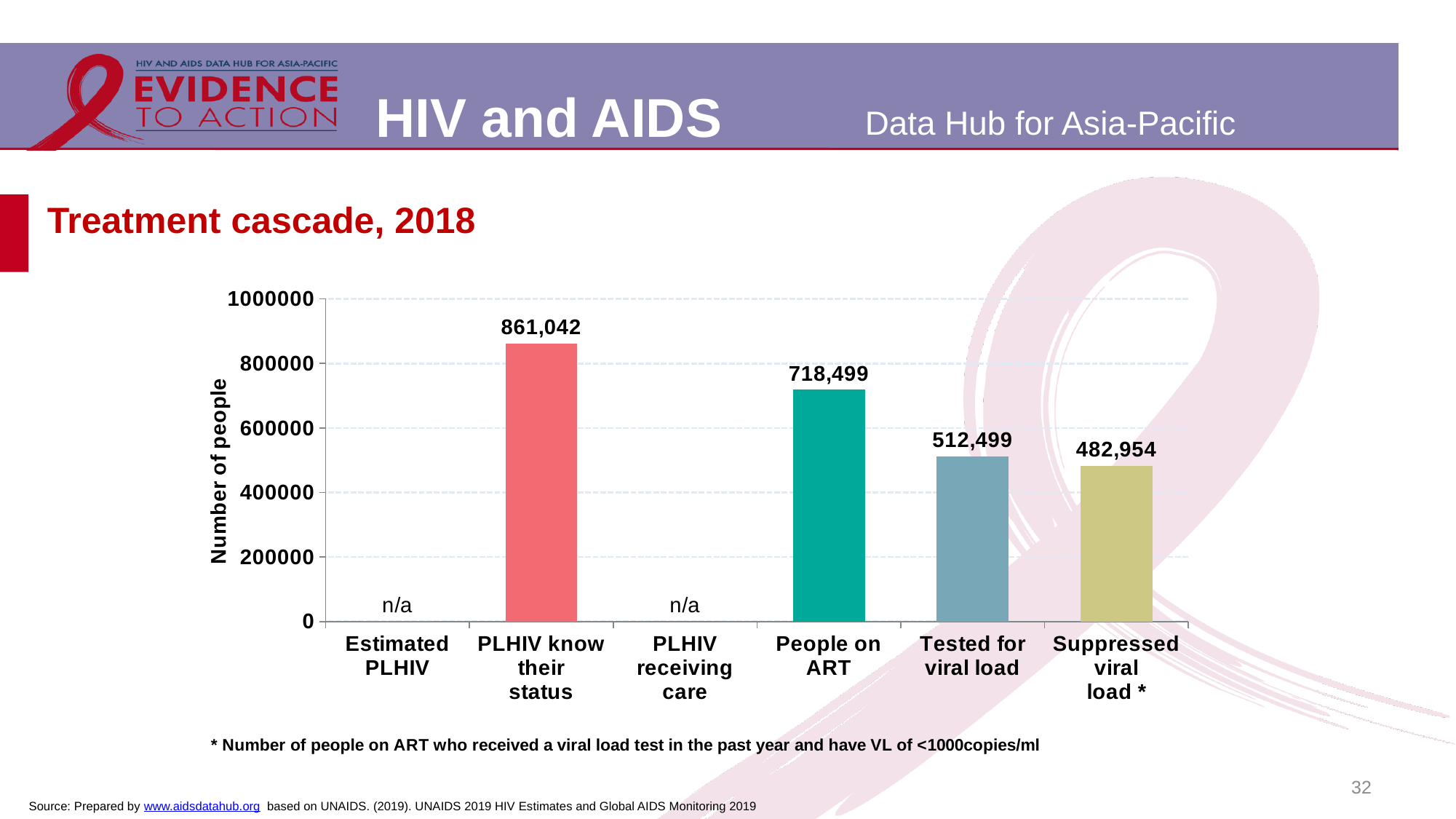
What is the value for PLHIV know their status? 861,042 What is the difference between Tested for viral load and Suppressed viral load? 29,545 Which category has the highest value? PLHIV know their status What is the value for People on ART? 718,499 Which category with a plotted bar has the lowest value? Suppressed viral load What kind of chart is this? bar chart What is the value for Suppressed viral load? 482,954 How many categories are shown on the x axis? 6 What label is shown for Estimated PLHIV and PLHIV receiving care? n/a What is the difference between PLHIV know their status and People on ART? 142,543 Which is larger, People on ART or Tested for viral load? People on ART What is the value for Tested for viral load? 512,499